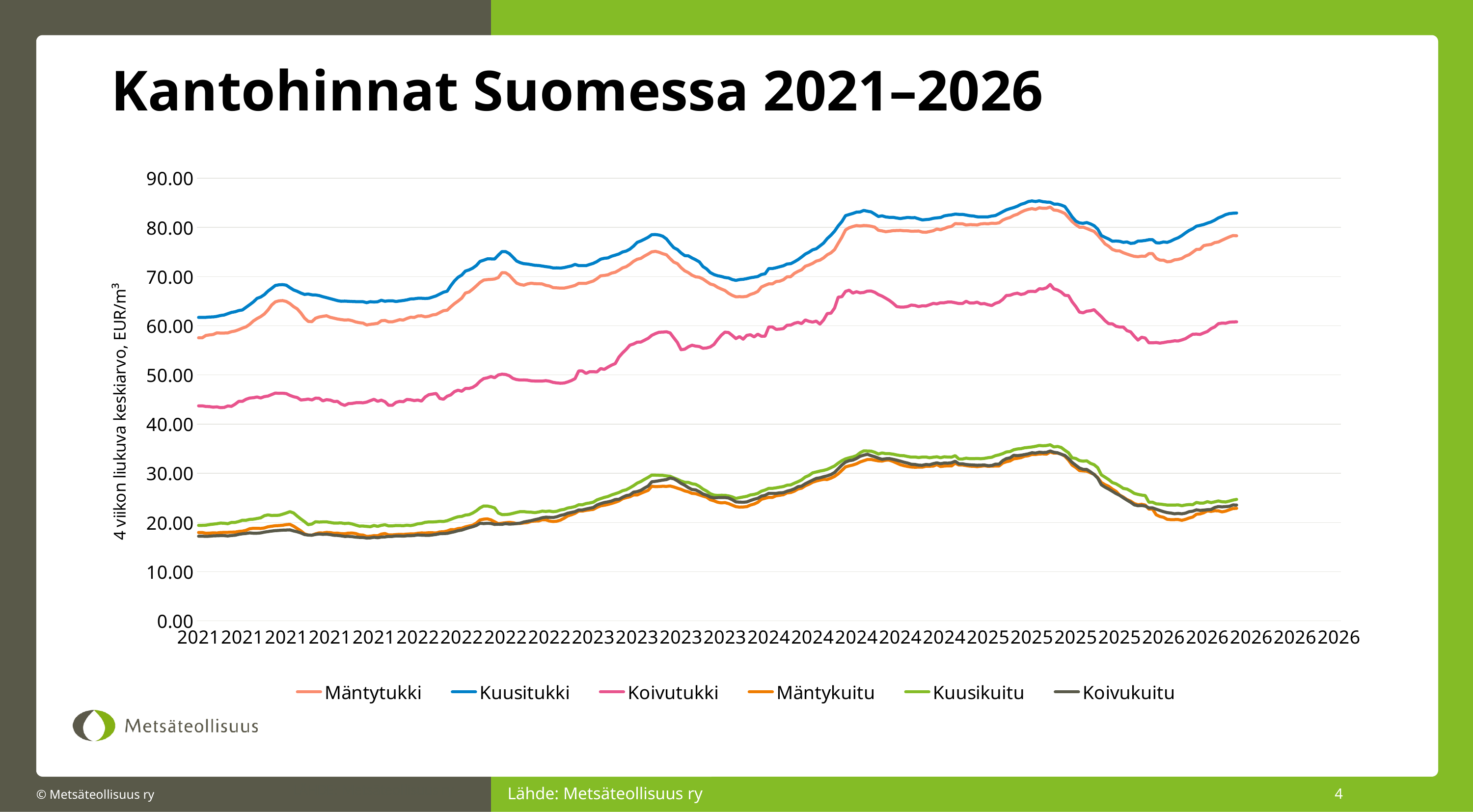
Is the value of Koivutukki at the start of 2021 greater or less than 50? less Which series has the highest values across the whole period? Kuusitukki What is the label of the vertical axis? 4 viikon liukuva keskiarvo, EUR/m³ Overall, does the Koivutukki series rise or fall from 2021 to 2026? rise At the end of the series in 2026, which is larger, Kuusitukki or Koivutukki? Kuusitukki How many series does the legend list? 6 Is the value of Kuusikuitu at the start of 2021 greater or less than 30? less What kind of chart is shown on the slide? line chart Is the peak value of Kuusitukki in 2025 greater or less than 80? greater What is the title of the chart? Kantohinnat Suomessa 2021–2026 Which of the three kuitu series (Mäntykuitu, Kuusikuitu, Koivukuitu) has the highest values? Kuusikuitu